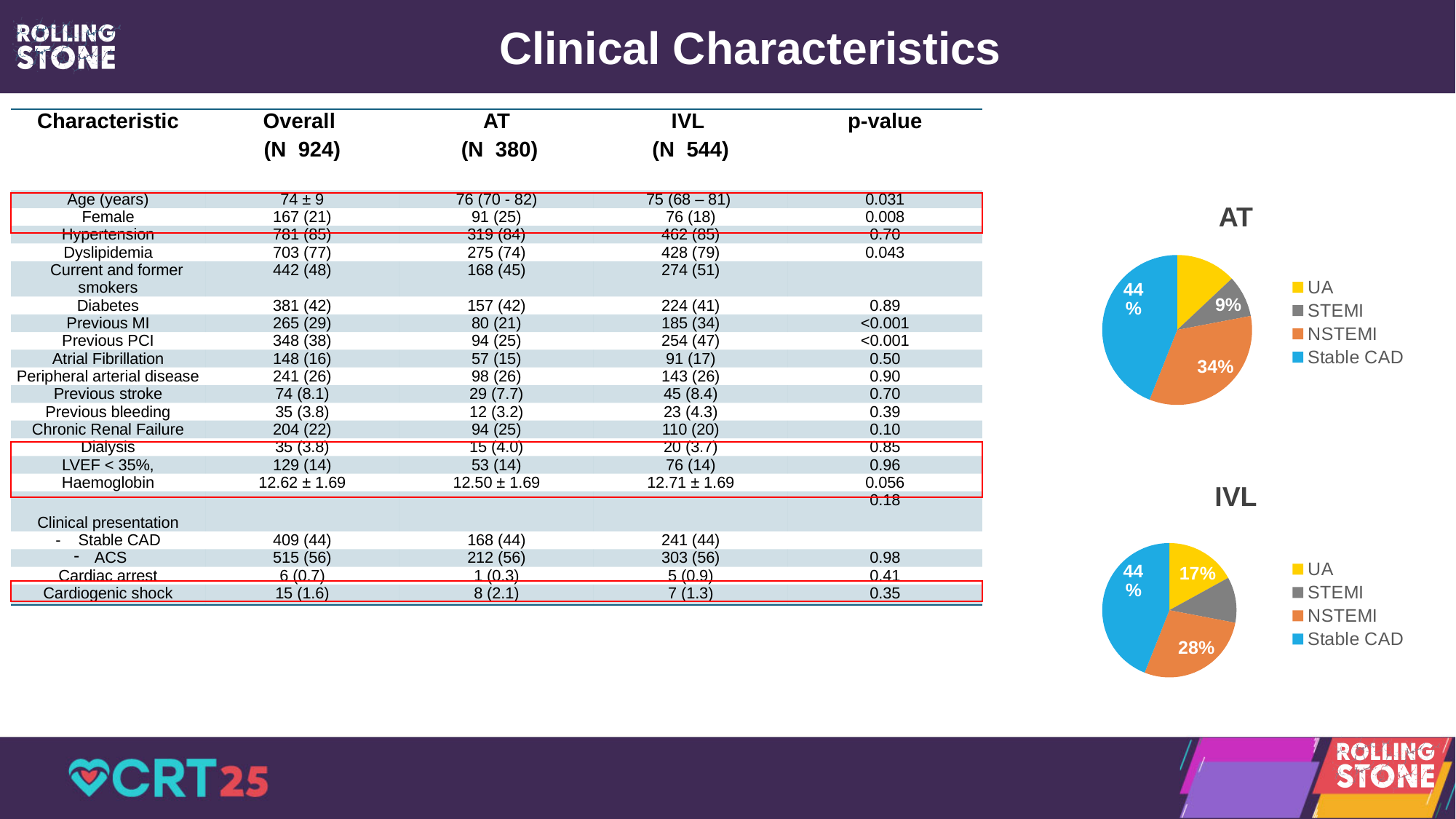
Is the NSTEMI share larger in the AT pie chart or in the IVL pie chart? AT In the AT pie chart, what share does Stable CAD have? 44% In the IVL pie chart, which category has the smallest slice? STEMI In the IVL pie chart, what share does Stable CAD have? 44% What kind of chart is the AT chart on the right of the slide? Pie chart How many categories does the legend of the IVL pie chart list? 4 In the AT pie chart, which category has the largest slice? Stable CAD In the IVL pie chart, what share does NSTEMI have? 28% In the IVL pie chart, which category has the largest slice? Stable CAD In the IVL pie chart, how many percentage points larger is the NSTEMI share than the UA share? 11